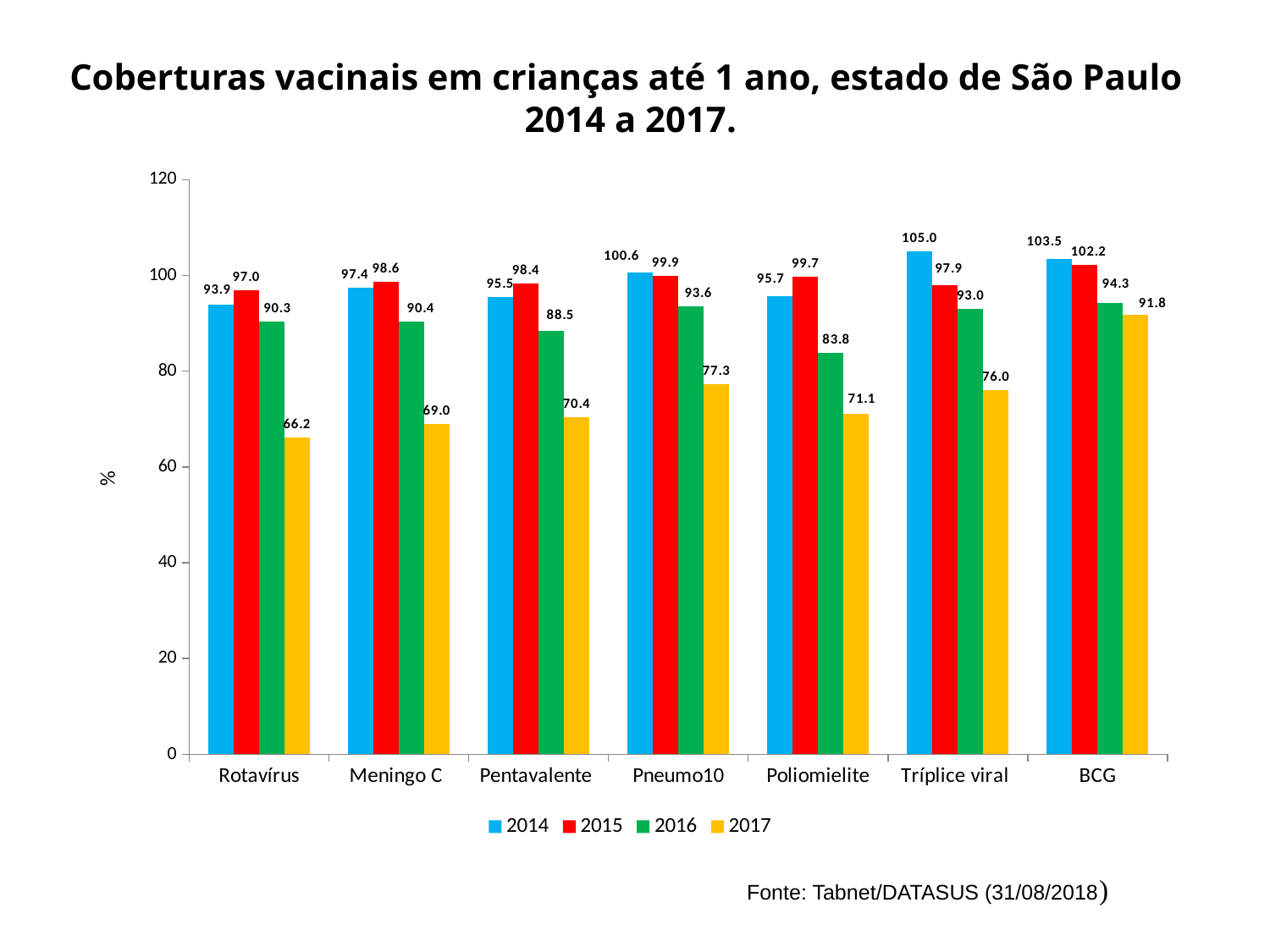
What kind of chart is shown on the slide? Bar chart What is the 2014 coverage value for Tríplice viral? 105.0 For Tríplice viral, do the values rise or fall from 2014 to 2017? Fall Which vaccine has the lowest 2017 coverage? Rotavírus What is the difference between the 2014 and 2017 values for BCG? 11.7 What is the 2017 coverage value for Rotavírus? 66.2 Which is larger, the 2017 value for Pneumo10 or the 2017 value for Poliomielite? Pneumo10 How many vaccine categories are shown on the x axis? 7 What is the difference between the 2015 and 2016 values for Poliomielite? 15.9 What is the 2016 coverage value for Pentavalente? 88.5 How many series does the legend list? 4 Which vaccine has the highest 2014 coverage? Tríplice viral